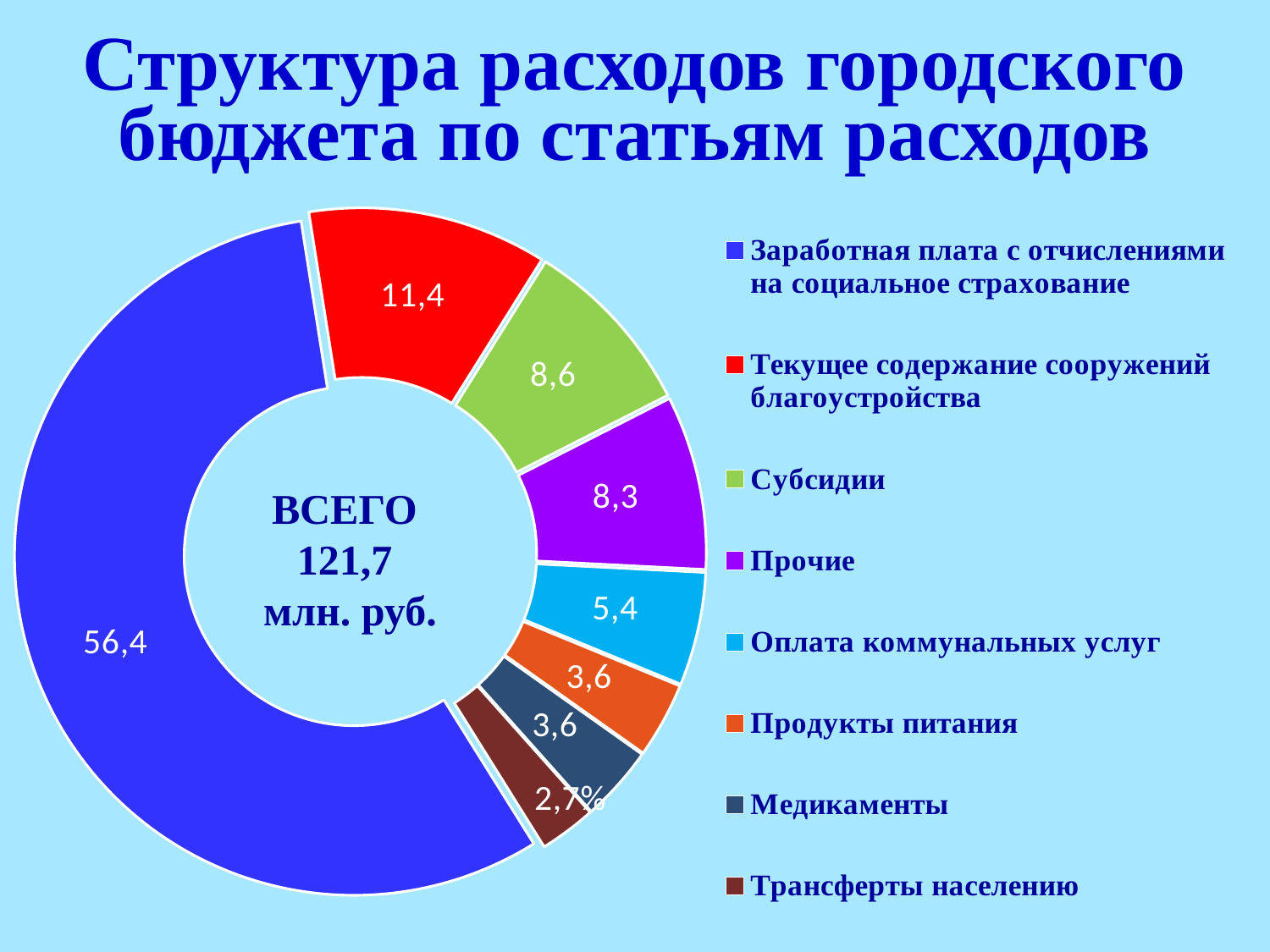
What total amount is written in the centre of the chart? ВСЕГО 121,7 млн. руб. What is the value shown for Заработная плата с отчислениями на социальное страхование? 56,4 What kind of chart is shown on the slide? Doughnut (pie) chart Which is larger: the value for Прочие or the value for Оплата коммунальных услуг? Прочие What is the value shown for Текущее содержание сооружений благоустройства? 11,4 Which category has the largest share of the chart? Заработная плата с отчислениями на социальное страхование Which category has the smallest share of the chart? Трансферты населению How many categories does the legend list? 8 What is the value shown for Субсидии? 8,6 What is the value shown for Трансферты населению? 2,7% What is the value shown for Оплата коммунальных услуг? 5,4 What is the difference between the values for Текущее содержание сооружений благоустройства and Субсидии? 2,8